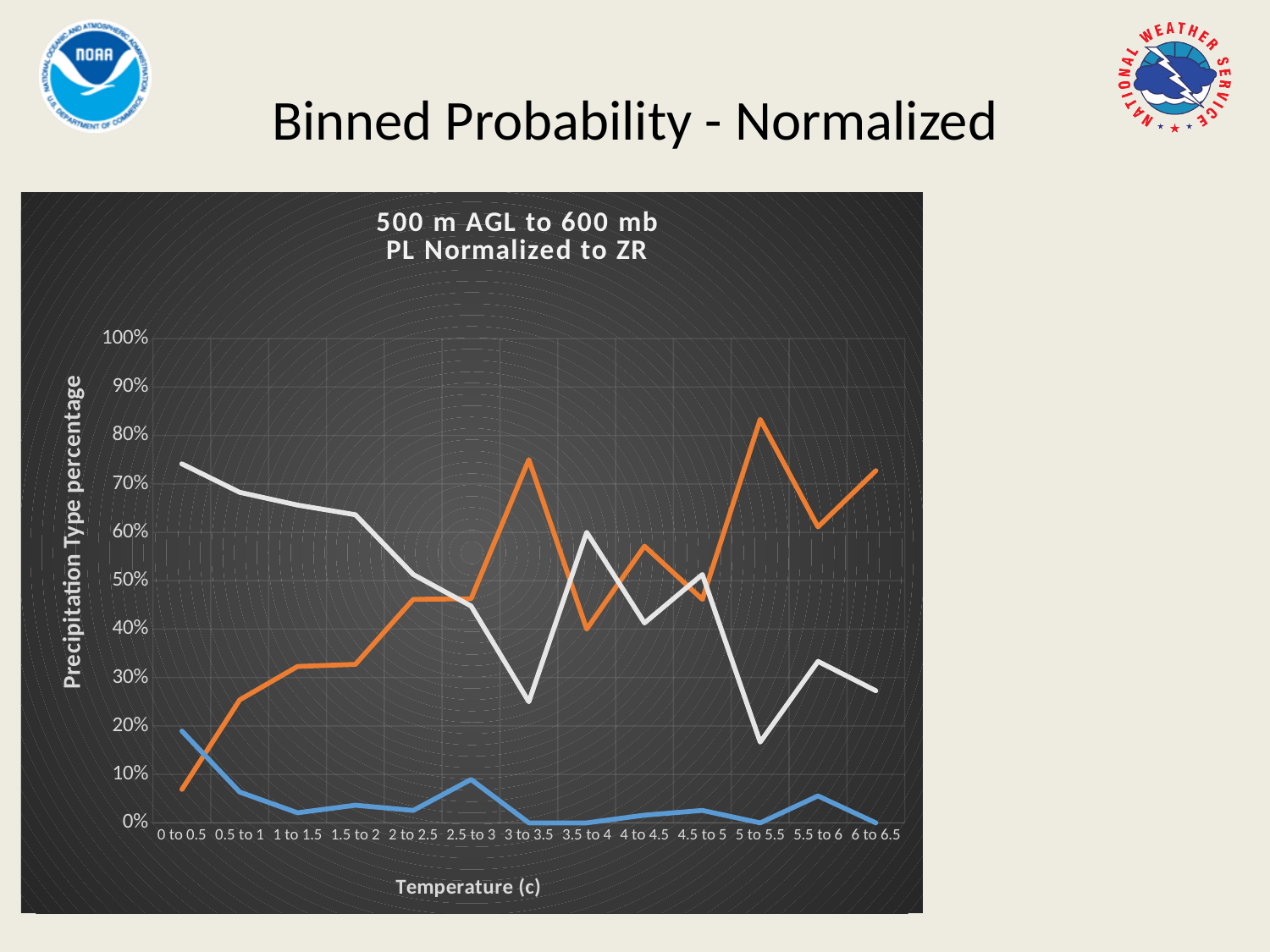
Is the value of the orange line for the 5 to 5.5 bin greater or less than 80%? greater Is the value of the white line for the 0 to 0.5 bin greater or less than 70%? greater In which temperature bin does the orange line reach its highest value? 5 to 5.5 For the 6 to 6.5 bin, which line has the larger value, the orange line or the white line? orange line Does the white line generally rise or fall as temperature increases along the x axis? fall Is the value of the orange line for the 0 to 0.5 bin greater or less than 10%? less How many temperature bins are shown along the x axis? 13 What kind of chart is shown on the slide? line chart What is the title of the chart? 500 m AGL to 600 mb PL Normalized to ZR What is the label of the x axis? Temperature (c) In which temperature bin does the white line reach its highest value? 0 to 0.5